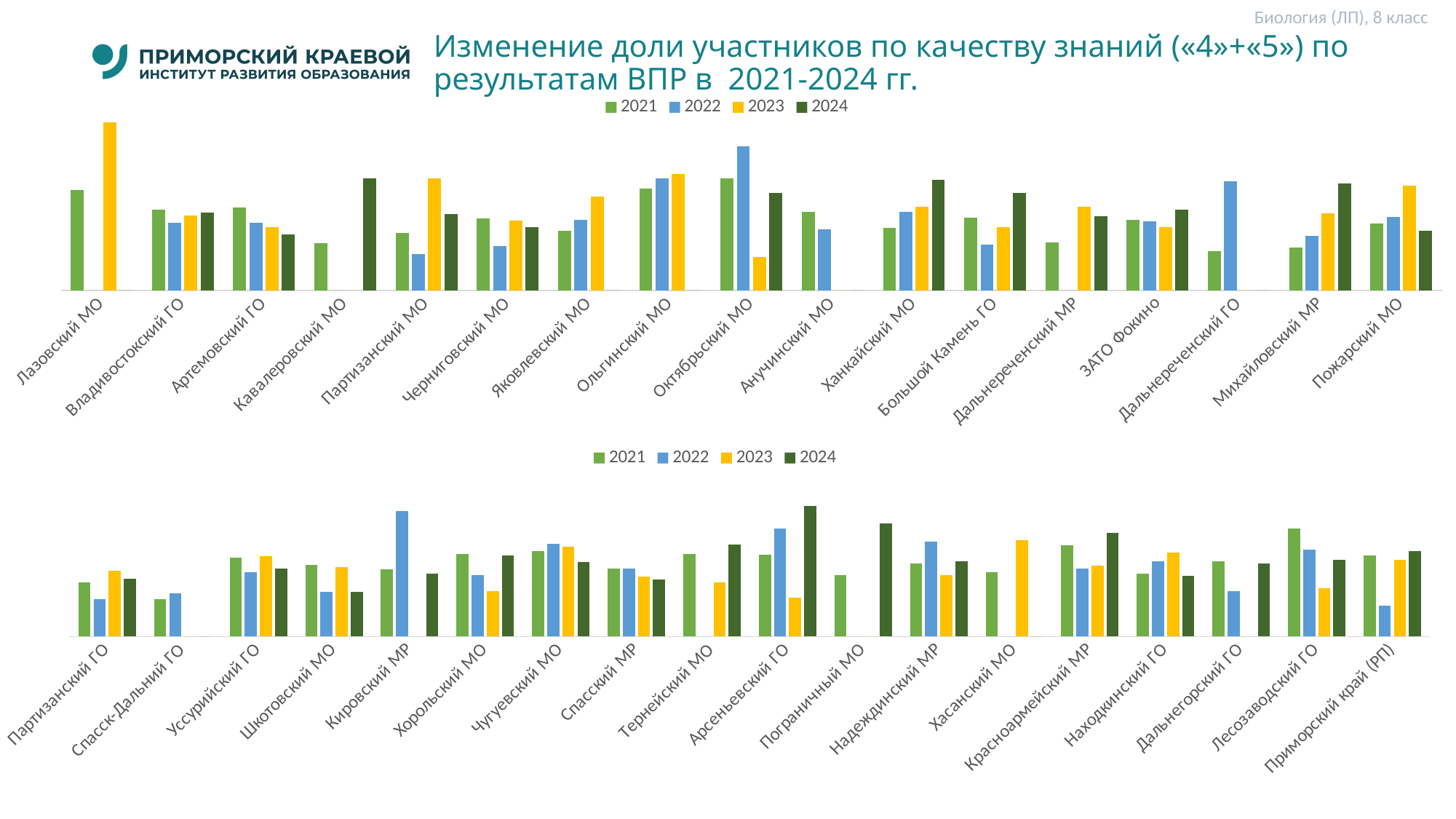
What kind of chart is the top chart on the slide? Bar chart What colour represents the 2023 series in the charts? Yellow In the bottom chart, for Кировский МР, which year has the highest value? 2022 How many categories are shown on the x axis of the bottom chart? 18 In the bottom chart, for Арсеньевский ГО, which is larger: the 2023 value or the 2024 value? 2024 How many series does the legend of the top chart list? 4 In the top chart, which category has the tallest bar overall? Лазовский МО In the top chart, do the values for Артемовский ГО rise or fall from 2021 to 2024? Fall How many categories are shown on the x axis of the top chart? 17 In the top chart, for Лазовский МО, which is larger: the 2021 value or the 2023 value? 2023 In the top chart, for Октябрьский МО, which year has the lowest value? 2023 What are the series listed in the legend of the bottom chart? 2021, 2022, 2023, 2024